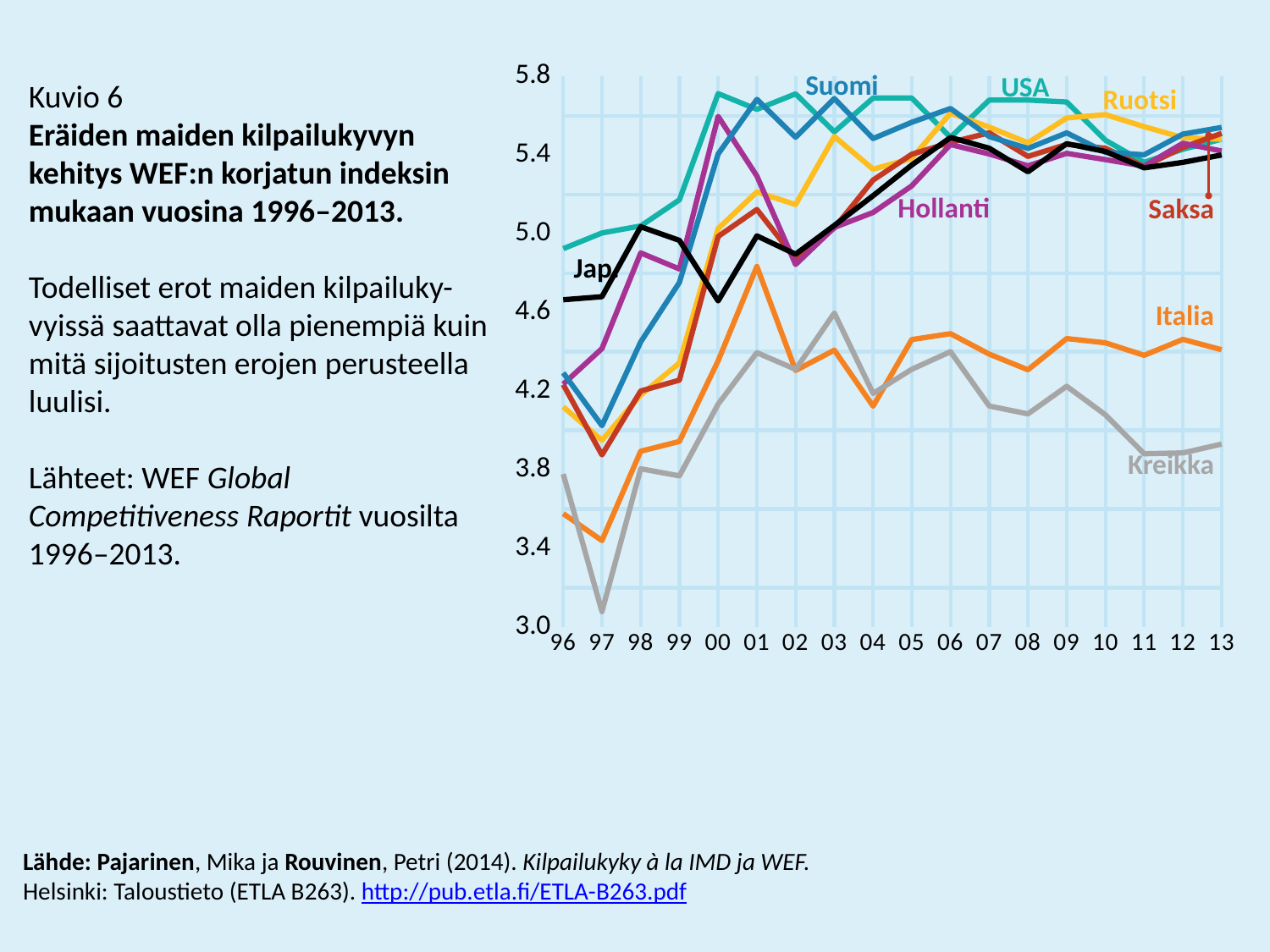
Is the value for Kreikka in 1997 greater or less than 3.4? less Which country has the lowest value in 1997? Kreikka Is the value for Suomi in 2001 greater or less than 5.4? greater What kind of chart is shown on the slide? line chart How many countries are plotted as lines in the chart? 8 In 2013, which is larger, the value for Italia or the value for Kreikka? Italia Is the value for Italia in 2013 greater or less than 4.6? less What is the highest tick value shown on the y axis? 5.8 How many years are shown on the x axis of the chart? 18 Which country has the highest value in 2000? USA Does the value for Suomi rise or fall from 1997 to 2001? rise